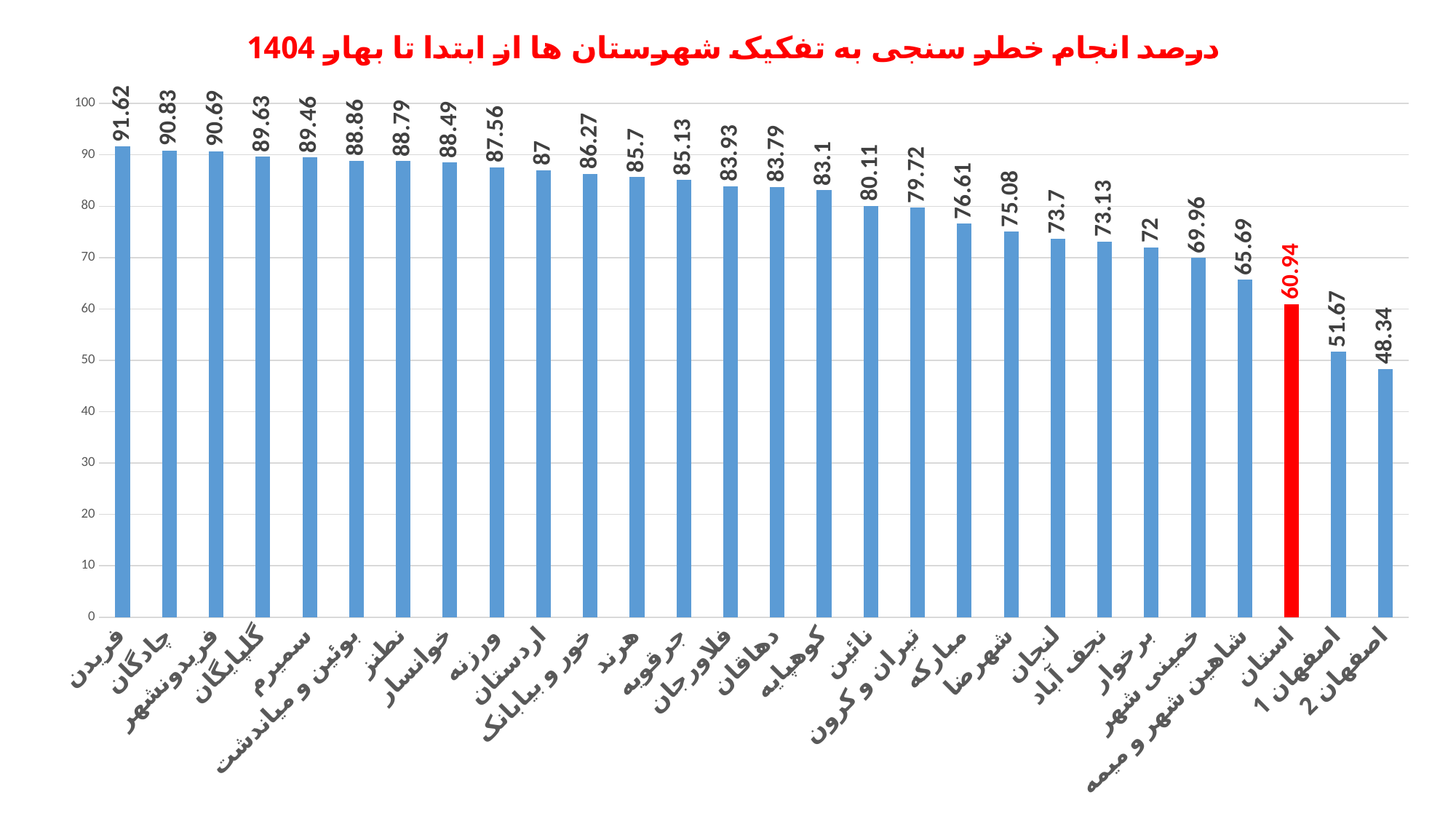
Which category has the lowest value? اصفهان 2 How many bars are plotted in the chart? 28 Which is larger, the value for مبارکه or the value for شهرضا? مبارکه What is the value for نجف آباد? 73.13 What is the difference between the values for اصفهان 1 and اصفهان 2? 3.33 Which category has the highest value? فریدن What is the value for استان (the red bar)? 60.94 What is the value for اصفهان 2? 48.34 What is the value for فریدن? 91.62 What type of chart is shown on the slide? bar chart Do the values generally rise or fall from left to right along the x axis? fall Which bar is coloured red instead of blue? استان